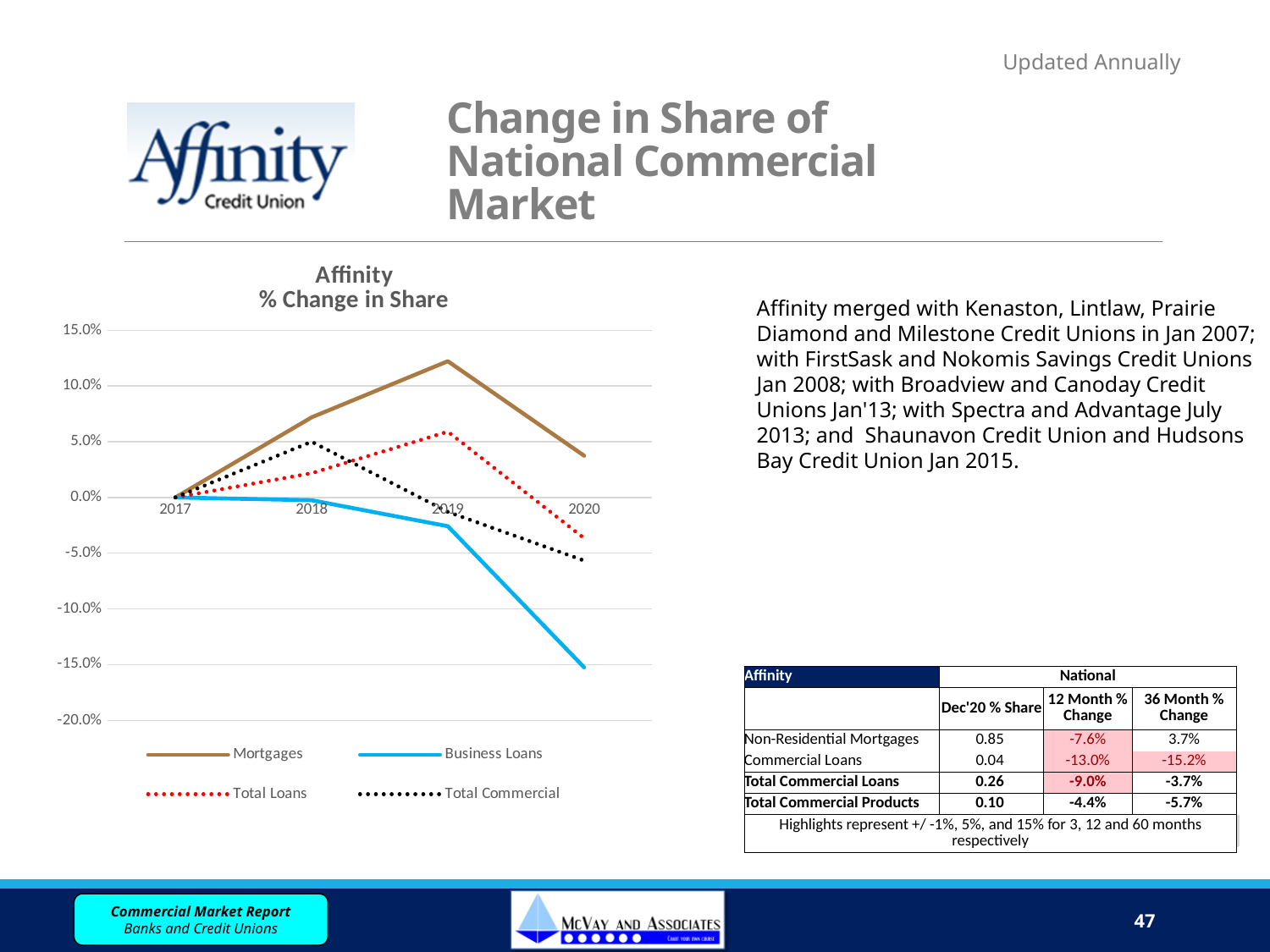
Is the value for Mortgages in 2019 greater or less than 10.0%? greater Which series has the highest value in 2020 on the "Affinity % Change in Share" chart? Mortgages How many years are shown on the x axis of the "Affinity % Change in Share" chart? 4 Is the value for Business Loans in 2020 greater or less than -10.0%? less In 2020, which is larger on the chart: Mortgages or Business Loans? Mortgages How many series does the legend of the "Affinity % Change in Share" chart list? 4 Is the value for Total Loans in 2020 greater or less than 0.0%? less Which series has the lowest value in 2020 on the "Affinity % Change in Share" chart? Business Loans What kind of chart is the "Affinity % Change in Share" chart? line chart Does the Business Loans line rise or fall from 2017 to 2020? fall Which series is drawn as a solid blue line in the "Affinity % Change in Share" chart? Business Loans